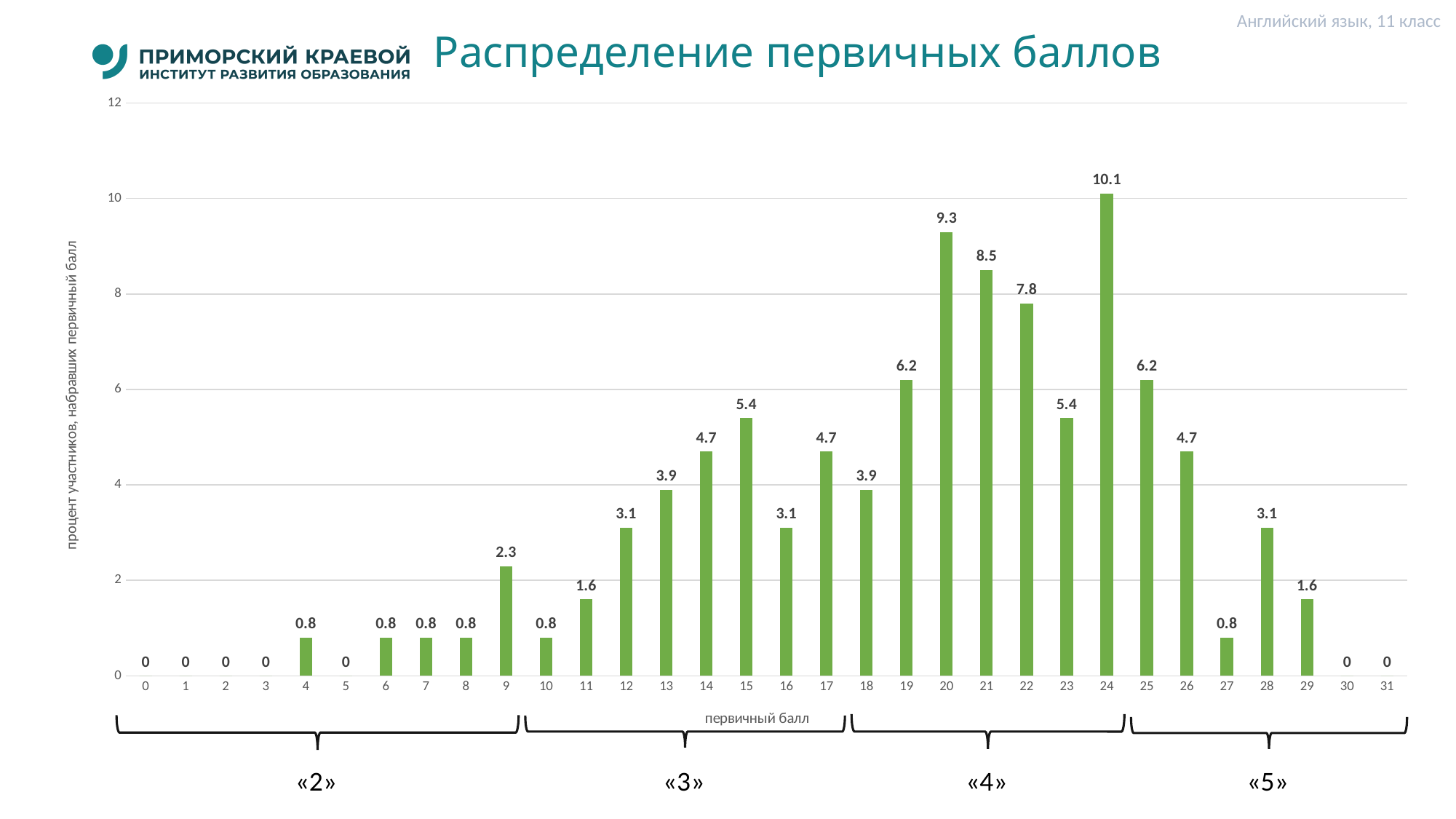
What is the value shown for primary score 9? 2.3 What percentage of participants scored a primary score of 24? 10.1 Which has a larger value, primary score 19 or primary score 23? 19 What is the difference between the values for primary scores 21 and 22? 0.7 What is the value shown for primary score 20? 9.3 How many primary score categories are shown on the x axis? 32 Which primary score has the highest percentage of participants? 24 What type of chart is shown on the slide? bar chart Is the value for primary score 22 greater or less than 8? less What is the title of the chart? Распределение первичных баллов What is the label of the x axis? первичный балл What is the difference between the values for primary scores 24 and 20? 0.8